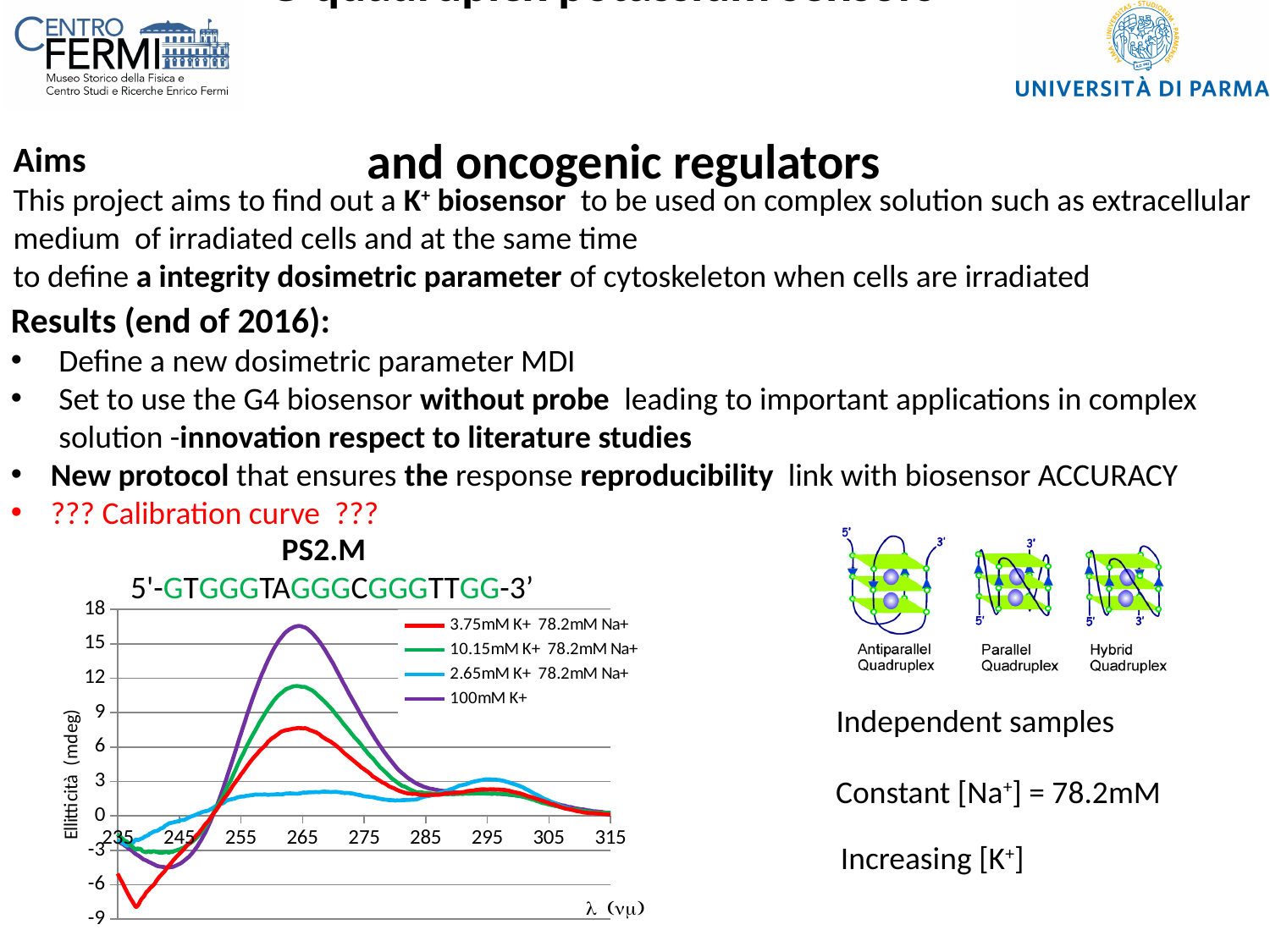
Is the peak value of the 100mM K+ series greater or less than 15? greater Is the value of the 2.65mM K+ 78.2mM Na+ series at 265 nm greater or less than 3? less What is the title shown above the chart? PS2.M At 265 nm, which series has the larger value: 10.15mM K+ 78.2mM Na+ or 3.75mM K+ 78.2mM Na+? 10.15mM K+ 78.2mM Na+ Which series reaches the highest peak value on the chart? 100mM K+ Is the minimum value of the 3.75mM K+ 78.2mM Na+ series near 240 nm greater or less than -6? less Which series has the lowest peak value around 265 nm? 2.65mM K+ 78.2mM Na+ What kind of chart is shown on the slide? line chart What is the label of the y axis of the chart? Ellitticità (mdeg) How many series does the chart legend list? 4